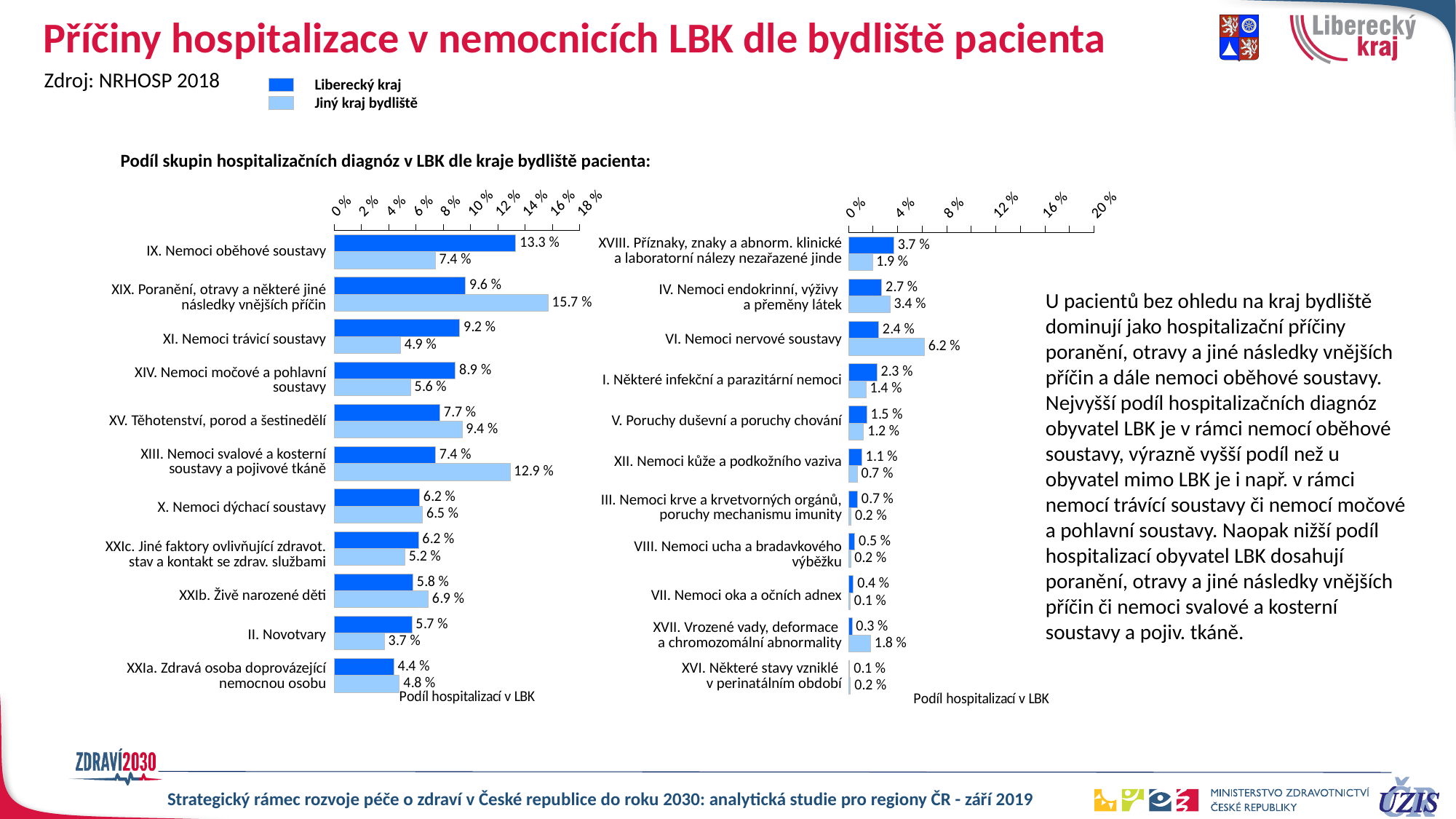
In the left chart, what is the value for Liberecký kraj for 'IX. Nemoci oběhové soustavy'? 13.3 % In the left chart, which category has the highest Liberecký kraj value? IX. Nemoci oběhové soustavy In the left chart, what is the difference between the Liberecký kraj and Jiný kraj bydliště values for 'XI. Nemoci trávicí soustavy'? 4.3 % How many series does the legend list? 2 In the right chart, what is the Liberecký kraj value for 'VI. Nemoci nervové soustavy'? 2.4 % In the right chart, which category has the lowest Liberecký kraj value? XVI. Některé stavy vzniklé v perinatálním období In the left chart, what is the value for Jiný kraj bydliště for 'XIX. Poranění, otravy a některé jiné následky vnějších příčin'? 15.7 % In the left chart, for 'XIII. Nemoci svalové a kosterní soustavy a pojivové tkáně', which series has the larger value? Jiný kraj bydliště In the right chart, what is the difference between the Jiný kraj bydliště and Liberecký kraj values for 'XVII. Vrozené vady, deformace a chromozomální abnormality'? 1.5 % In the right chart, is the Jiný kraj bydliště value for 'VI. Nemoci nervové soustavy' greater or less than 4 %? greater How many categories are shown in the left chart? 11 What type of chart is used on this slide? Bar chart